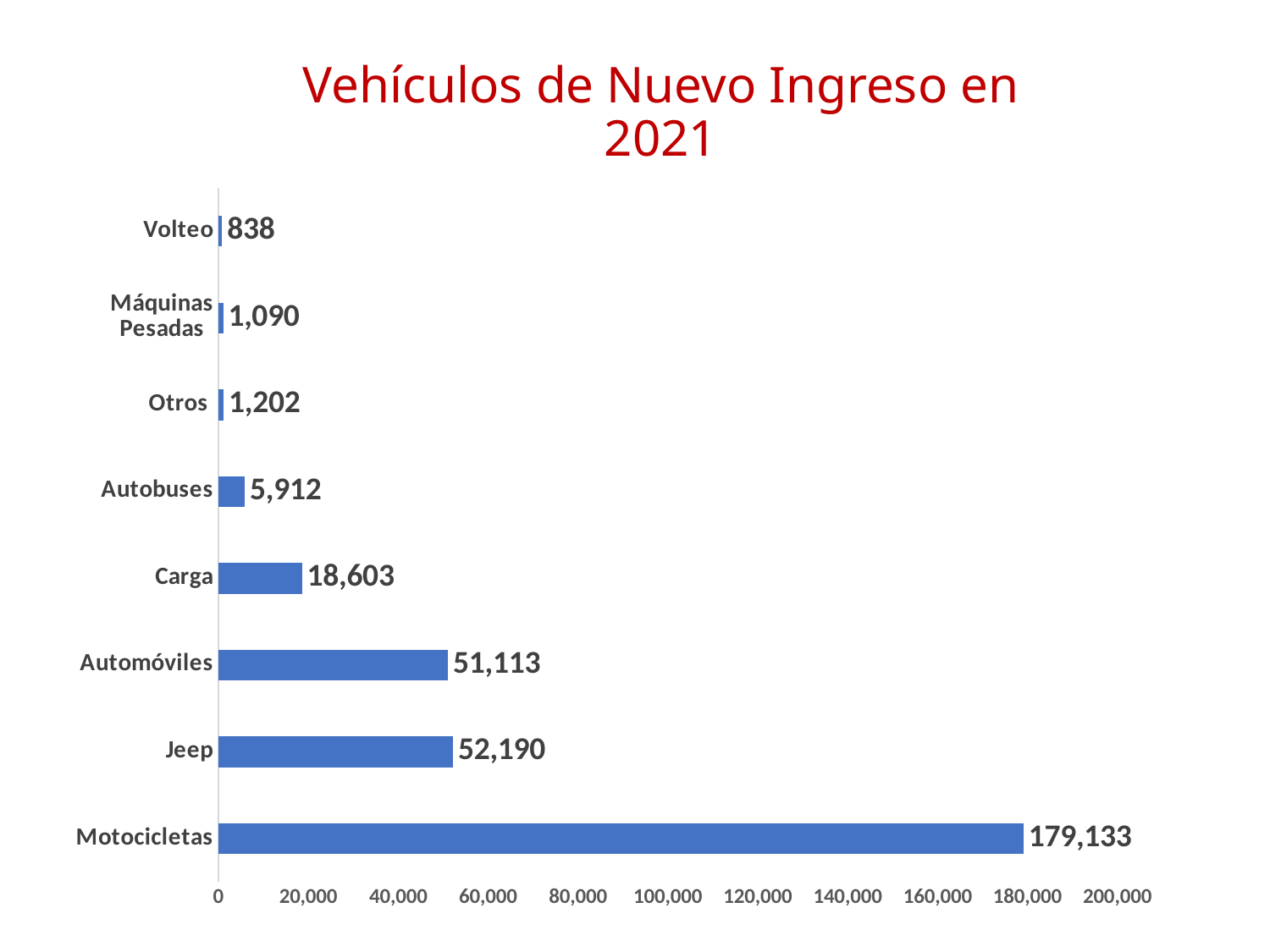
Is the value for Automóviles greater or less than 60,000? less What is the value for Máquinas Pesadas? 1,090 What is the difference between the values for Jeep and Automóviles? 1,077 What is the value for Carga? 18,603 What kind of chart is shown on the slide? bar chart Which category has the highest value? Motocicletas How many categories are shown in the chart? 8 What is the value for Motocicletas? 179,133 Which category has the lowest value? Volteo Which is larger, the value for Autobuses or the value for Otros? Autobuses What is the difference between the values for Carga and Autobuses? 12,691 What is the title of the chart? Vehículos de Nuevo Ingreso en 2021